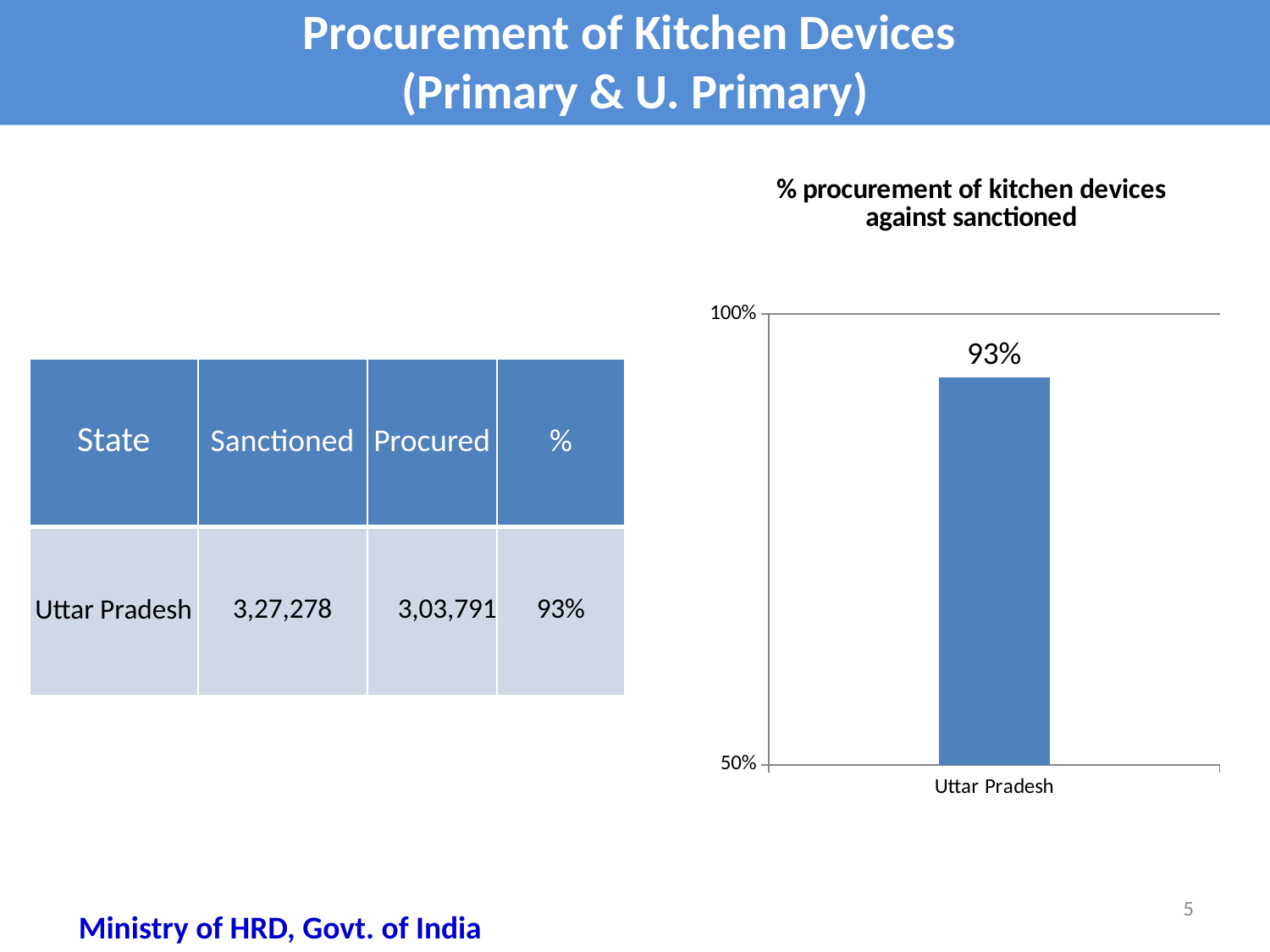
How many categories are plotted in the chart? 1 What is the title of the chart? % procurement of kitchen devices against sanctioned Is the value for Uttar Pradesh greater or less than 100%? less Is the value for Uttar Pradesh greater or less than 50%? greater What is the highest value shown on the y axis of the chart? 100% Which state is shown on the x axis of the chart? Uttar Pradesh What kind of chart is shown on the slide? bar chart What is the value for Uttar Pradesh in the chart? 93% What is the lowest value shown on the y axis of the chart? 50%